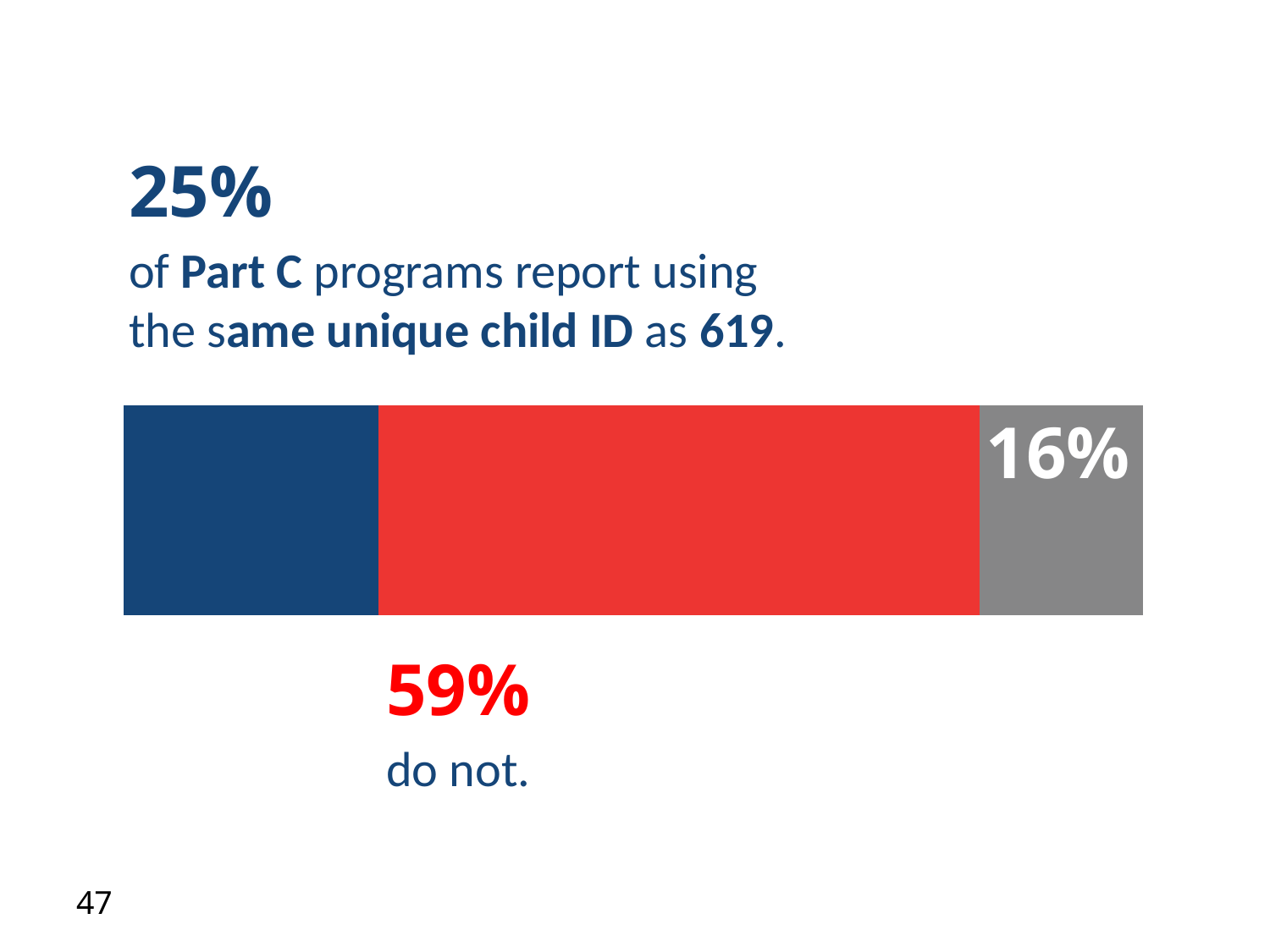
What kind of chart is shown on the slide? A stacked bar chart Which segment of the bar is the largest? The red segment (59%, do not) Which segment of the bar is the smallest? The gray segment (16%) Which is larger: the share of Part C programs using the same unique child ID as 619, or the share that do not? The share that do not (59%) Is the value for the gray segment greater or less than 25%? less How many segments make up the stacked bar? 3 What do the three segments of the bar add up to? 100% What value is printed on the gray segment of the bar? 16% What is the difference in percentage points between the programs that do not use the same unique child ID (59%) and those that do (25%)? 34 percentage points What percentage of Part C programs report using the same unique child ID as 619? 25% What percentage of Part C programs do not use the same unique child ID as 619? 59% What colour is the segment representing the 25% of Part C programs that use the same unique child ID as 619? Blue